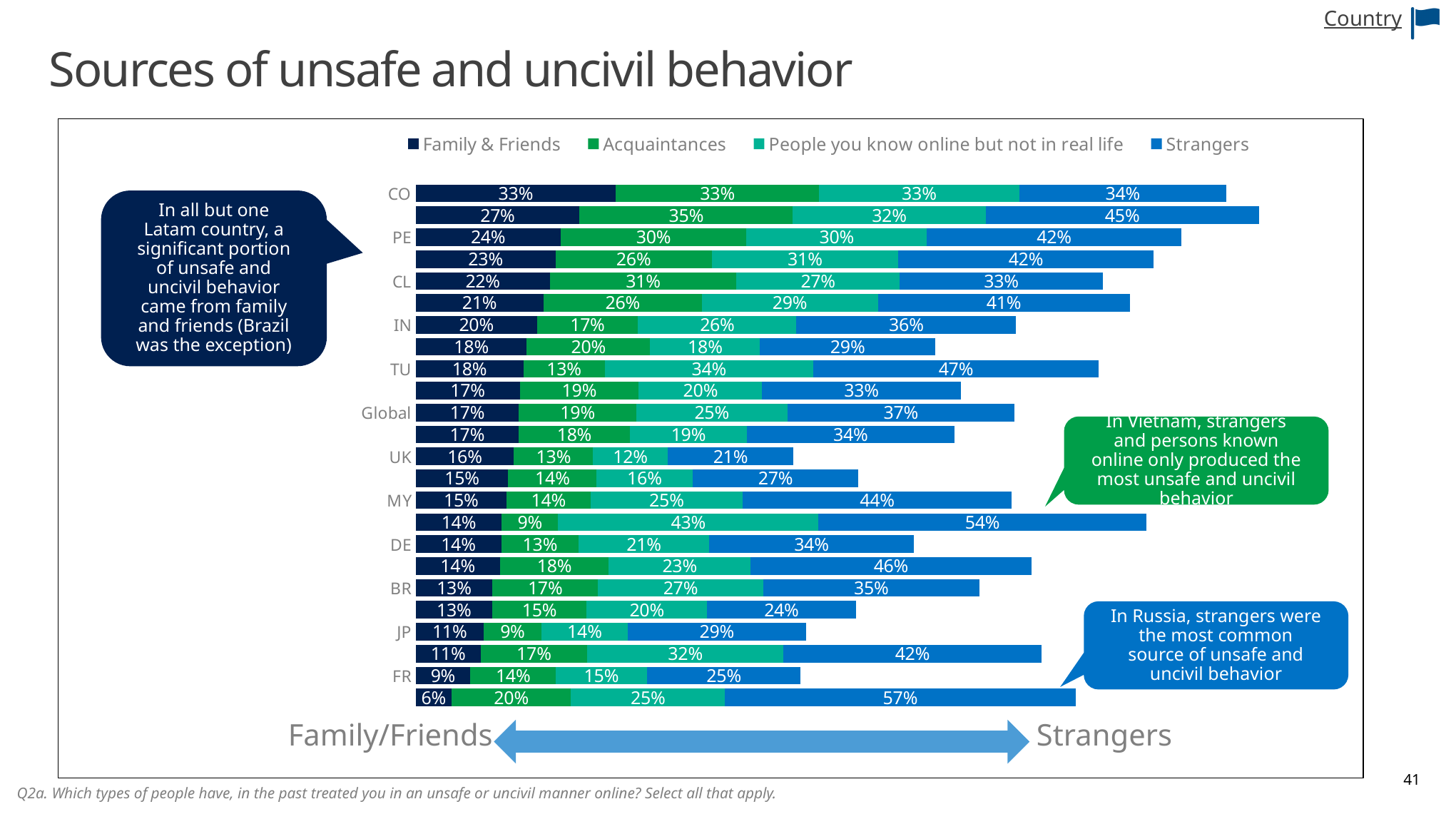
What is the Acquaintances value for PE? 30% Which has the larger Strangers value, MY or DE? MY What is the total of the four segments in the UK bar? 62% What is the Strangers value for TU? 47% How many series does the legend list? 4 Which labeled country has the highest Family & Friends value? CO Which labeled country has the lowest Strangers value? UK What kind of chart is shown on the slide? Stacked bar chart What is the Acquaintances value for JP? 9% What is the difference between the Strangers value for TU and the Strangers value for UK? 26 percentage points What is the Family & Friends value for CO? 33% What is the value for People you know online but not in real life for Global? 25%